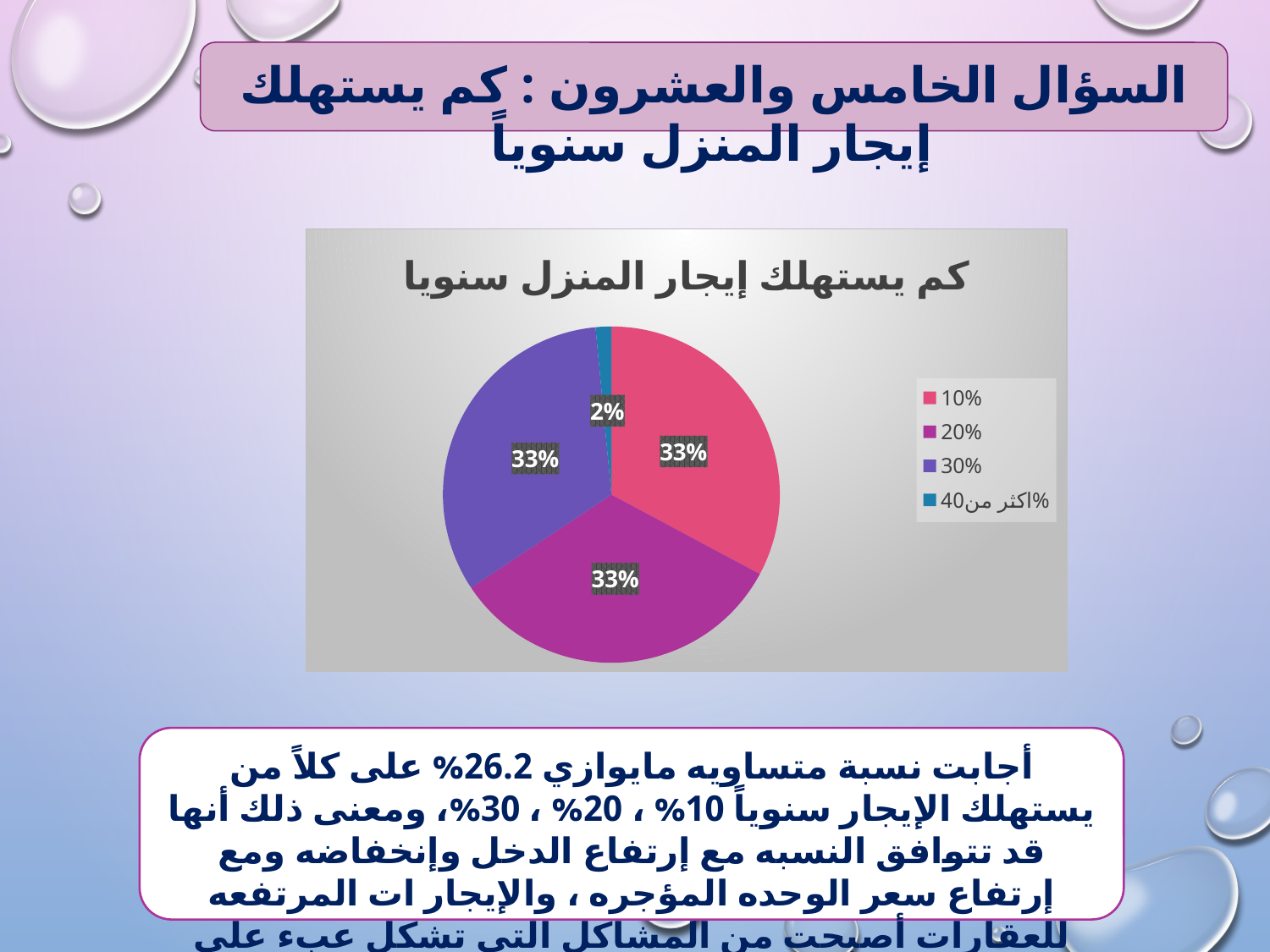
What share of the pie does the 20% category take? 33% What is the difference between the share for 30% and the share for اكثر من 40%? 31% How many categories are shown in the pie chart? 4 What kind of chart is shown on the slide? pie chart How many entries does the legend list? 4 What colour is the slice for the 30% category? purple What is the title of the chart? كم يستهلك إيجار المنزل سنويا What share of the pie does the 30% category take? 33% What share of the pie does the 10% category take? 33% What share of the pie does the اكثر من 40% category take? 2% Which category has the smallest slice of the pie? اكثر من 40% Which is larger: the slice for 10% or the slice for اكثر من 40%? 10%